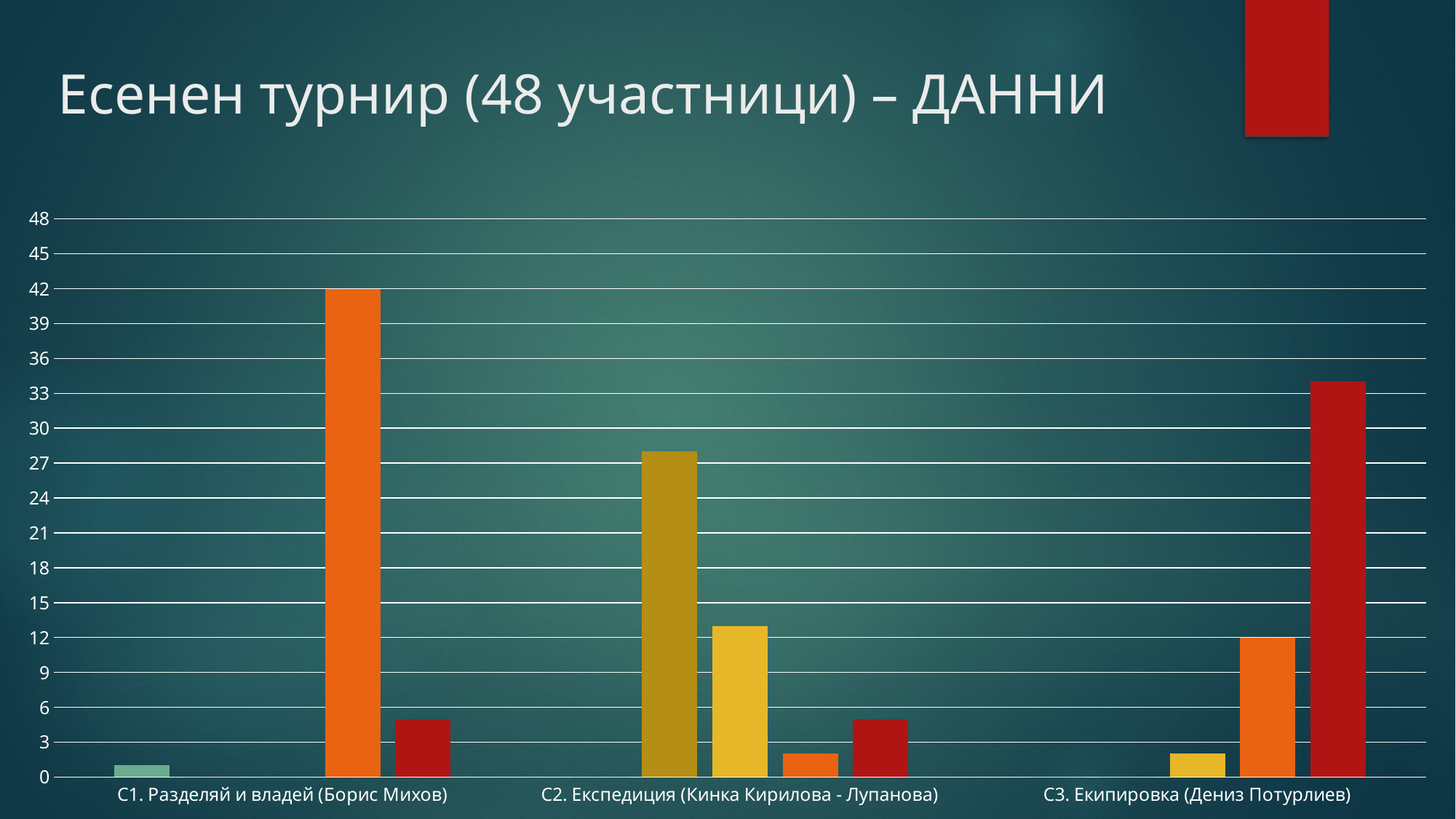
What kind of chart is shown on the slide? bar chart Which category contains the tallest bar in the chart? С1. Разделяй и владей (Борис Михов) Is the value of the red bar in 'С3. Екипировка (Дениз Потурлиев)' greater or less than 30? greater Which is larger: the orange bar in 'С1. Разделяй и владей (Борис Михов)' or the red bar in 'С3. Екипировка (Дениз Потурлиев)'? the orange bar in С1. Разделяй и владей (Борис Михов) What is the value of the orange bar in the category 'С3. Екипировка (Дениз Потурлиев)'? 12 How many categories are shown on the x axis? 3 Is the value of the yellow bar in 'С2. Експедиция (Кинка Кирилова - Лупанова)' greater or less than 15? less Is the value of the dark gold bar in 'С2. Експедиция (Кинка Кирилова - Лупанова)' greater or less than 24? greater How many bars are shown for the category 'С2. Експедиция (Кинка Кирилова - Лупанова)'? 4 What is the title of the slide? Есенен турнир (48 участници) – ДАННИ What is the value of the orange bar in the category 'С1. Разделяй и владей (Борис Михов)'? 42 What is the difference between the orange bar in 'С1. Разделяй и владей (Борис Михов)' and the orange bar in 'С3. Екипировка (Дениз Потурлиев)'? 30